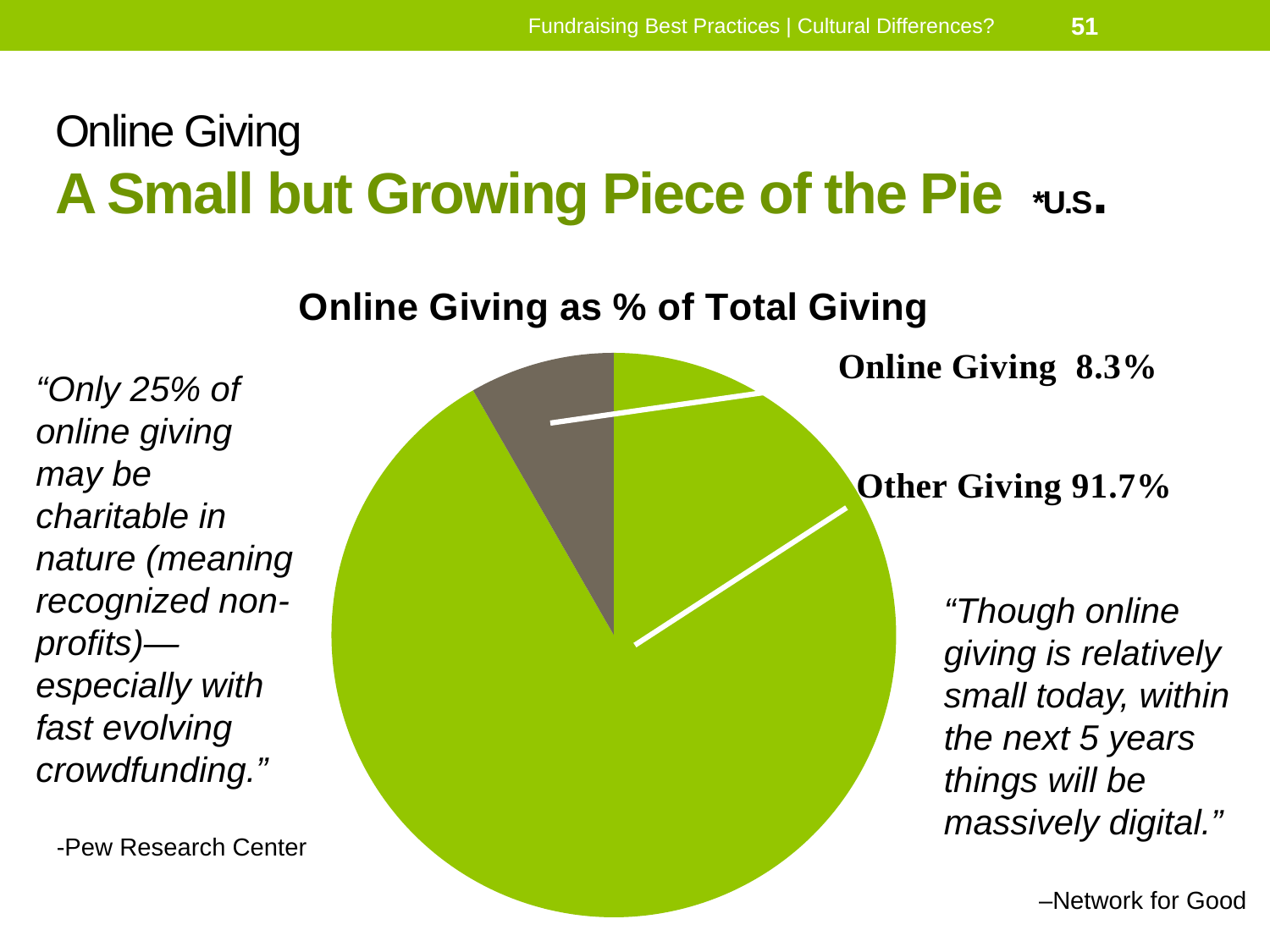
Which is larger, Online Giving or Other Giving? Other Giving What is the title of the chart? Online Giving as % of Total Giving What share of the pie does the Online Giving slice represent? 8.3% What is the value for Other Giving in the pie chart? 91.7% Which slice of the pie chart is the largest? Other Giving What colour is the Online Giving slice of the pie chart? Grey What is the difference between the Other Giving and Online Giving values? 83.4% How many slices does the pie chart have? 2 Which slice of the pie chart is the smallest? Online Giving What is the value for Online Giving in the pie chart? 8.3% What kind of chart is shown on the slide? Pie chart